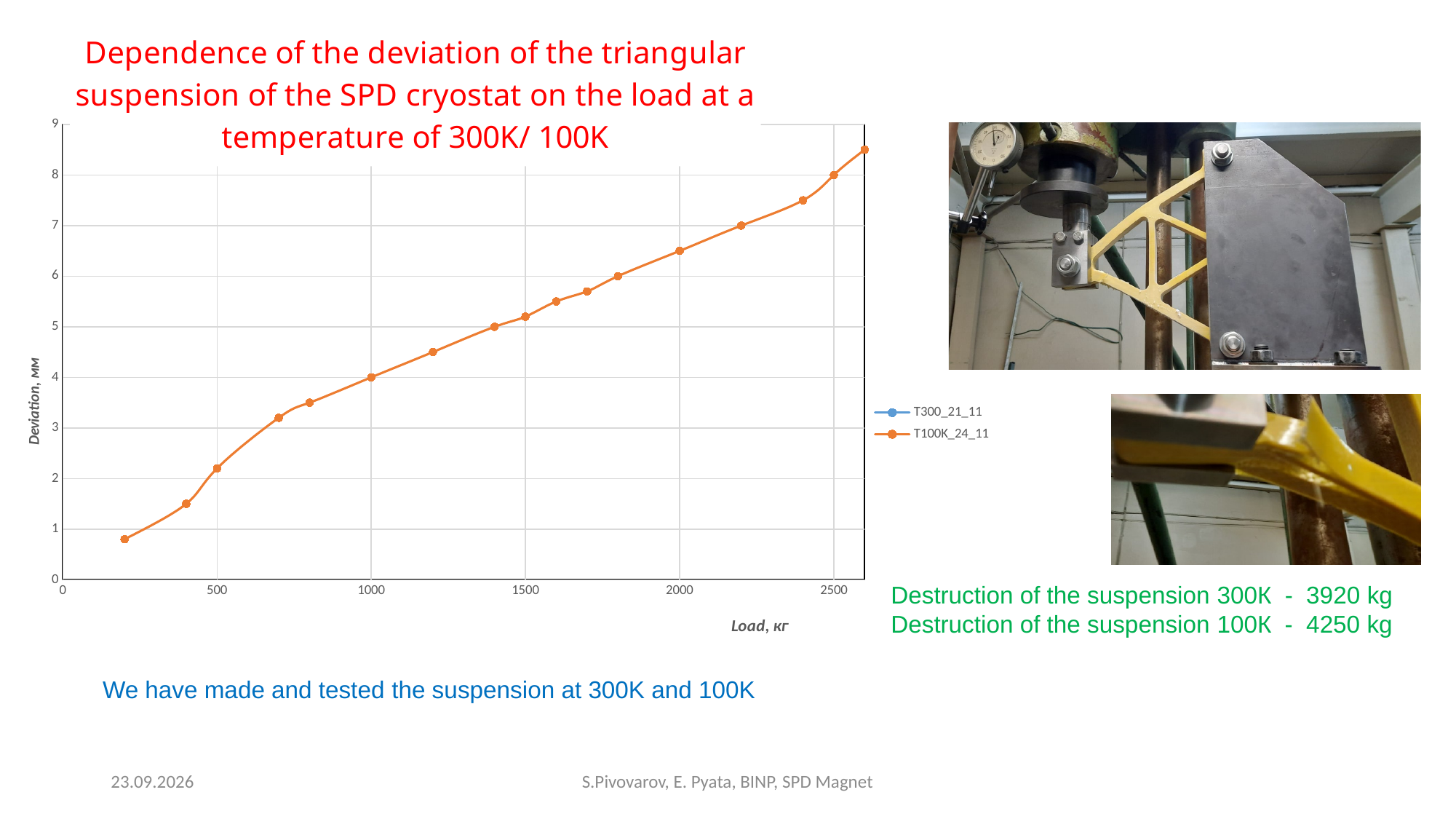
What is the deviation at a load of 1000? 4 Is the deviation at a load of 1000 greater or less than 3? greater What is the deviation at a load of 2500? 8 What kind of chart is shown on the slide? line chart Is the deviation at a load of 2000 greater or less than 6? greater Is the deviation at a load of 1500 greater or less than 6? less Does the deviation rise or fall as the load increases along the x axis? rises What is the label of the vertical axis of the chart? Deviation, мм How many series does the chart legend list? 2 What are the two series names listed in the chart legend? T300_21_11 and T100K_24_11